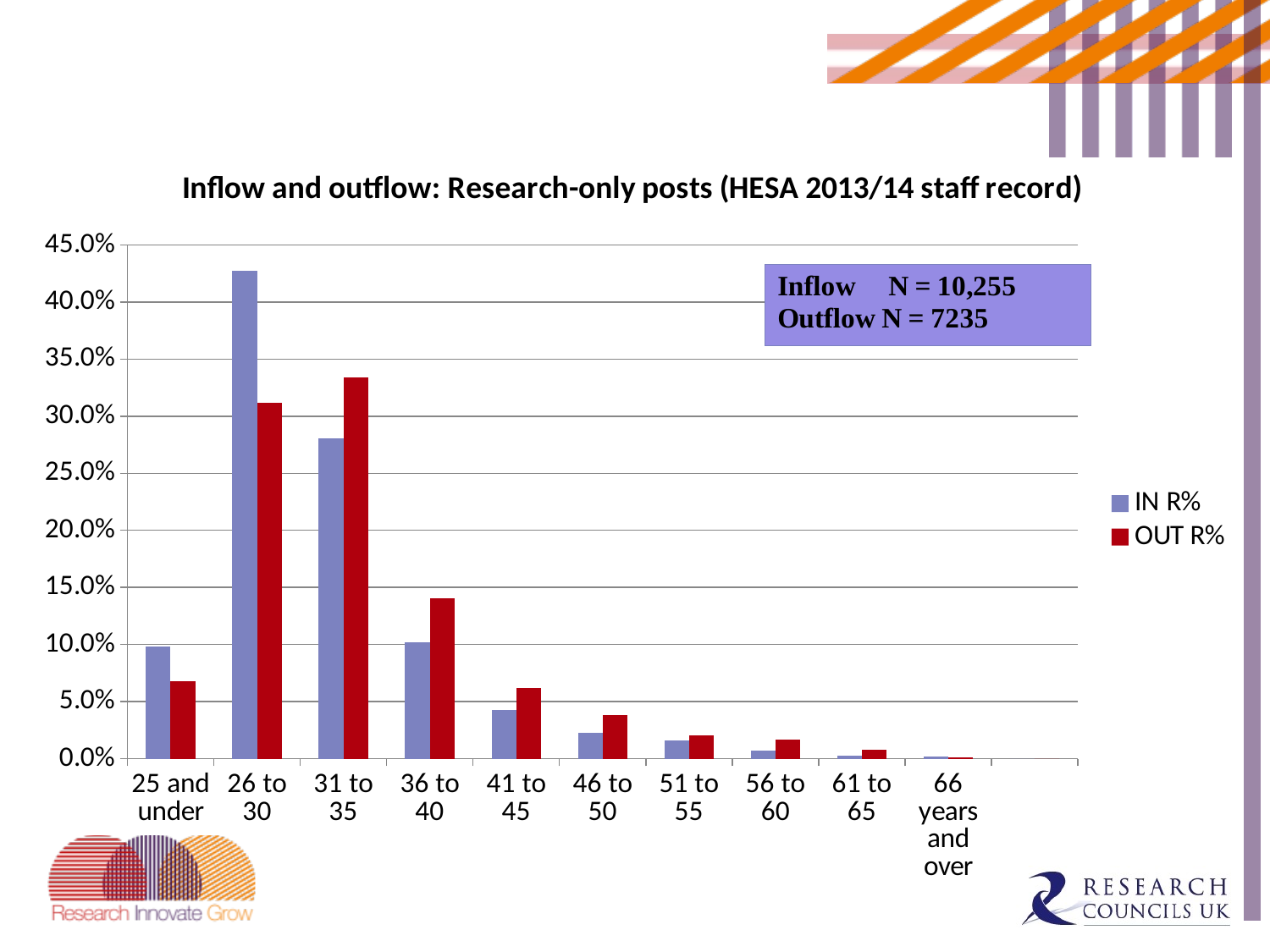
Is the IN R% value for 26 to 30 greater or less than 40.0%? greater For the 31 to 35 category, which is larger, IN R% or OUT R%? OUT R% Is the OUT R% value for 31 to 35 greater or less than 30.0%? greater How many series does the legend list? 2 What is the title of the chart? Inflow and outflow: Research-only posts (HESA 2013/14 staff record) Is the OUT R% value for 36 to 40 greater or less than 15.0%? less How many age categories are shown on the x axis? 10 Which age category has the highest OUT R% value? 31 to 35 For the 26 to 30 category, which is larger, IN R% or OUT R%? IN R% Which age category has the highest IN R% value? 26 to 30 What kind of chart is shown on the slide? Bar chart From the 26 to 30 category onward, do the IN R% values rise or fall as age increases? fall